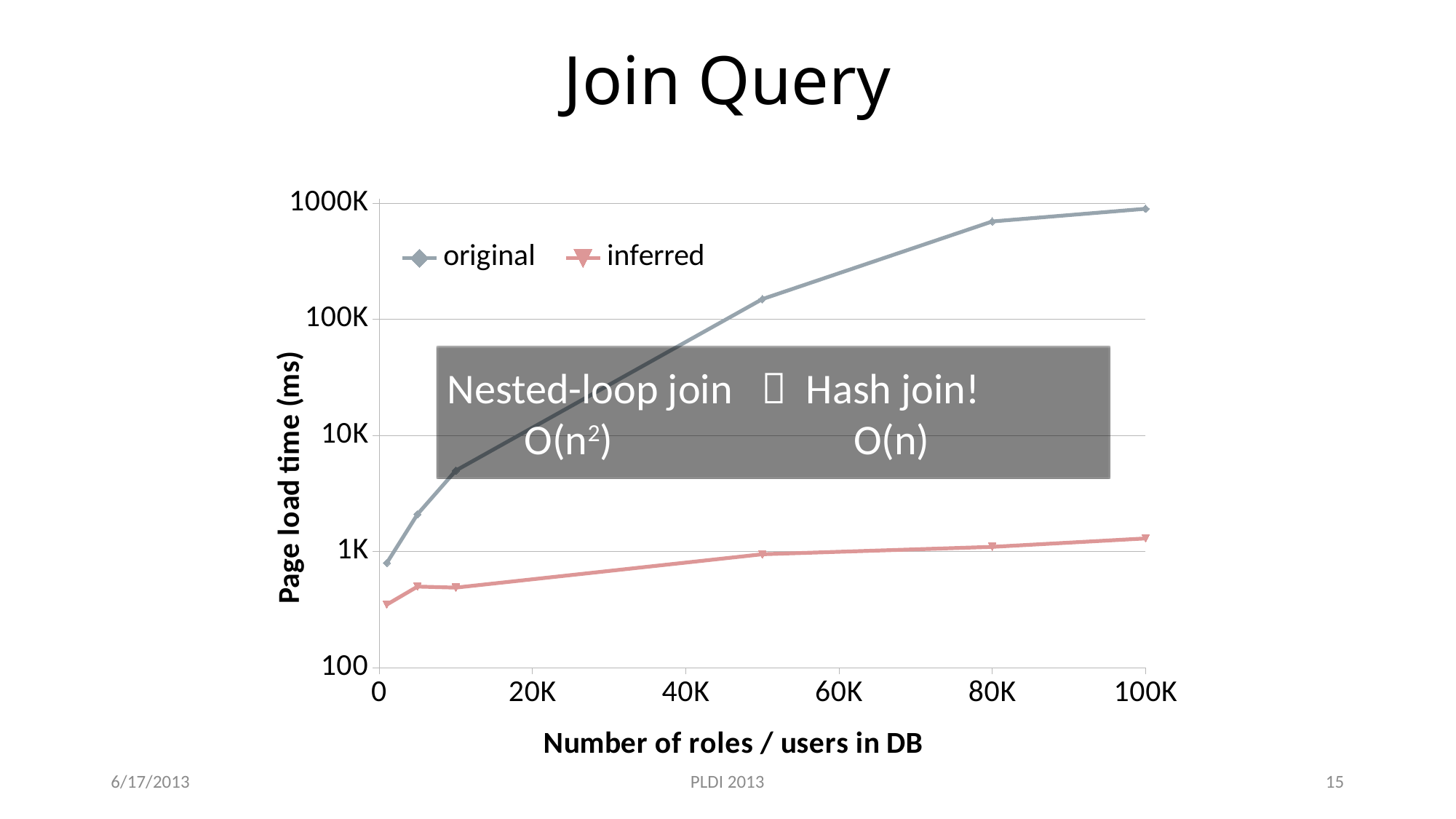
Is the value for the inferred series at 10K greater or less than 1K ms? less Is the value for the original series at 10K greater or less than 10K ms? less How many series does the legend list? 2 How many data points are plotted for the original series? 6 What kind of chart is shown on the slide? line chart Is the value for the original series at 80K greater or less than 100K ms? greater What is the label of the y axis? Page load time (ms) What is the label of the x axis? Number of roles / users in DB Which series has the higher page load time at 100K roles/users? original Does the page load time for the original series rise or fall as the number of roles/users increases? rise